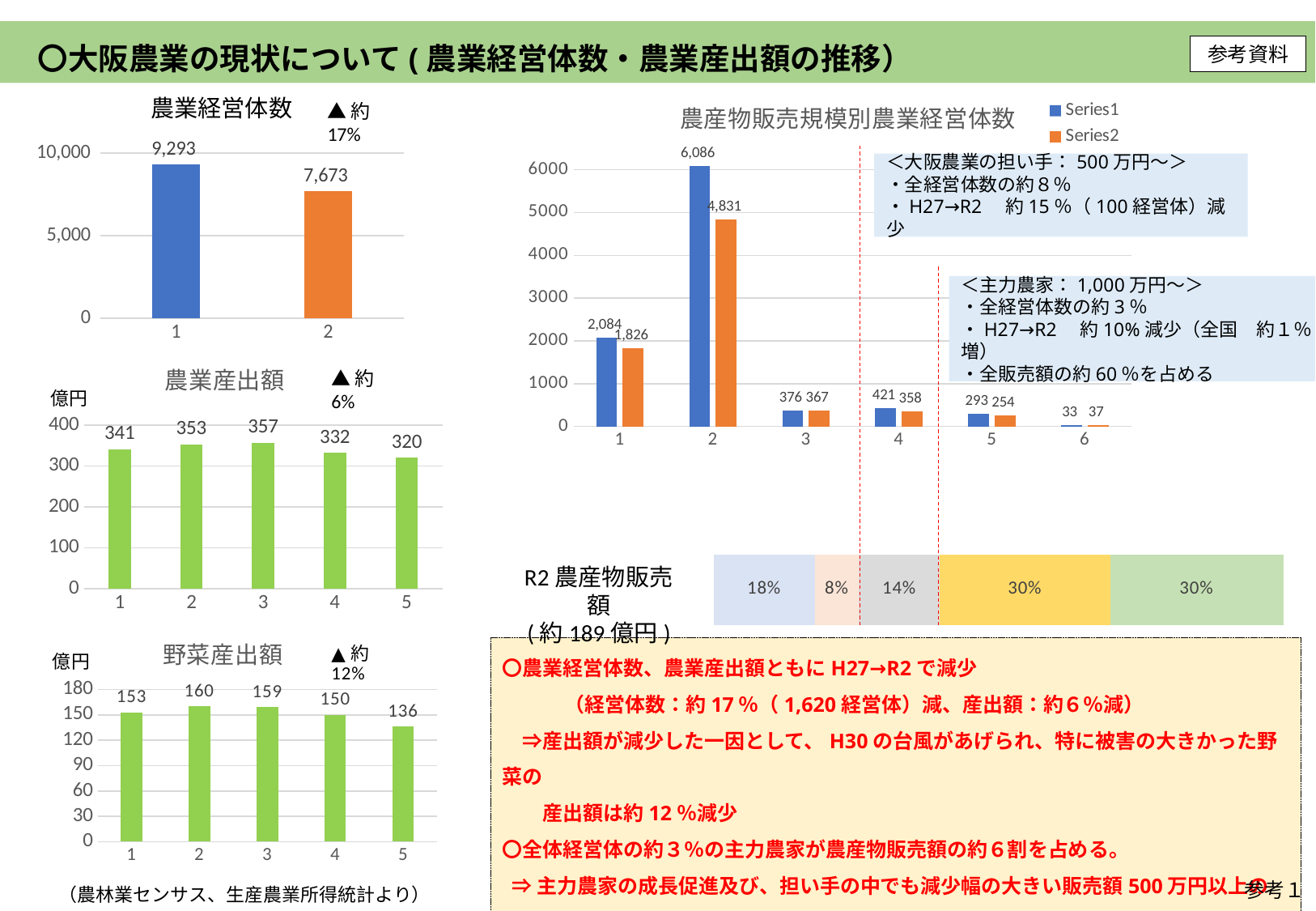
In the 農産物販売規模別農業経営体数 chart, what is the Series1 value for category 2? 6,086 In the 農業経営体数 chart, what is the difference between the values for category 1 and category 2? 1,620 In the 農業経営体数 chart, what is the value for category 1? 9,293 In the 農業産出額 chart, what is the value for category 4? 332 In the 野菜産出額 chart, what is the difference between the values for category 2 and category 5? 24 In the 野菜産出額 chart, how many categories are plotted? 5 In the 農産物販売規模別農業経営体数 chart, how many series does the legend list? 2 In the 農業産出額 chart, which category has the lowest value? 5 In the 農業産出額 chart, which category has the highest value? 3 In the 野菜産出額 chart, what is the value for category 5? 136 In the 農業経営体数 chart, what is the value for category 2? 7,673 In the 農産物販売規模別農業経営体数 chart, which is larger for category 6, Series1 or Series2? Series2